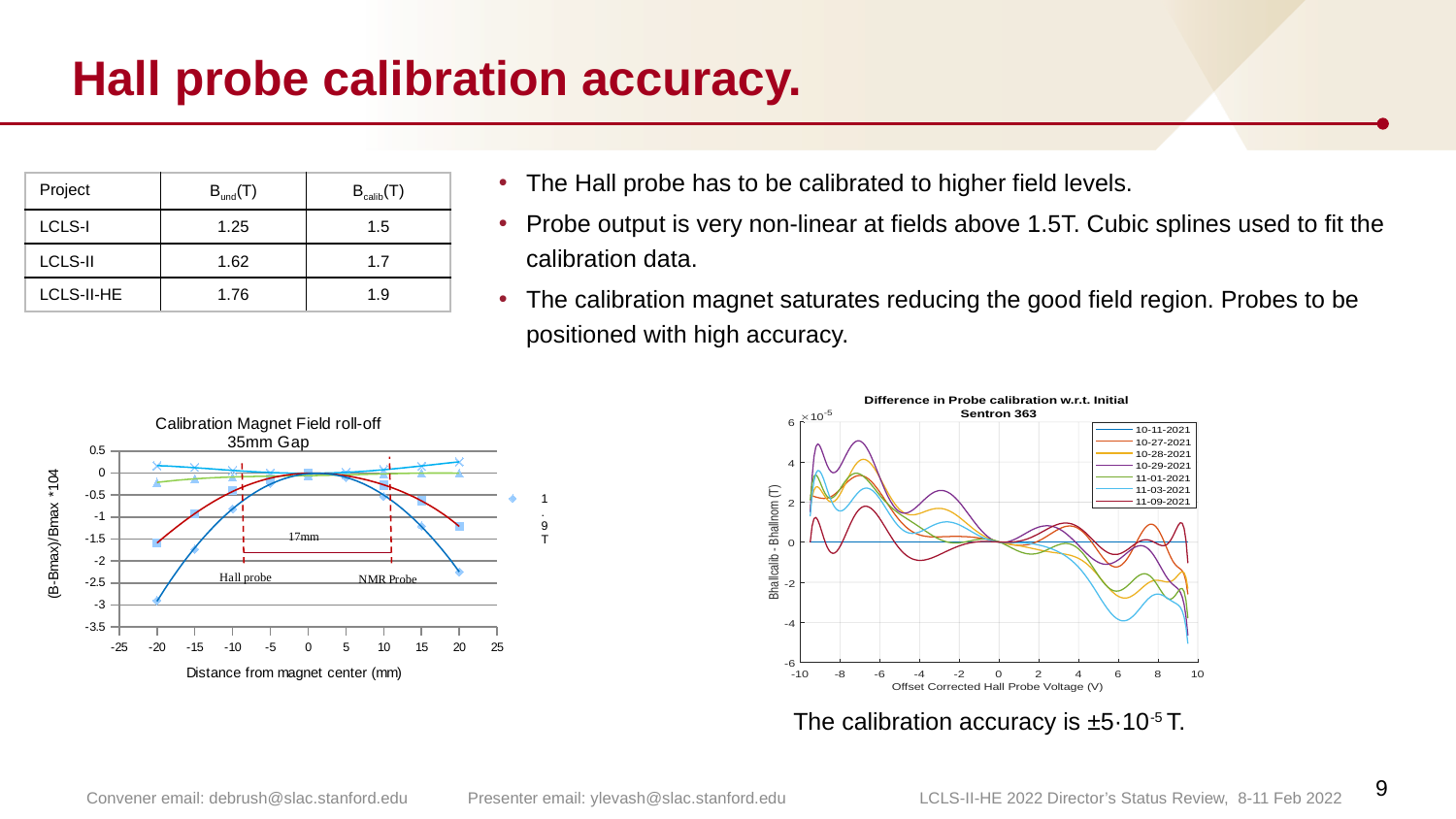
In the 'Difference in Probe calibration w.r.t. Initial Sentron 363' chart, what is the first entry in the legend? 10-11-2021 What is the x-axis label of the 'Calibration Magnet Field roll-off 35mm Gap' chart? Distance from magnet center (mm) What is the title of the chart on the left of the slide? Calibration Magnet Field roll-off 35mm Gap How many series does the legend of the 'Difference in Probe calibration w.r.t. Initial Sentron 363' chart list? 7 In the 'Calibration Magnet Field roll-off 35mm Gap' chart, is the lowest plotted value greater or less than -2.5? less What kind of chart is the 'Difference in Probe calibration w.r.t. Initial Sentron 363' chart? line chart